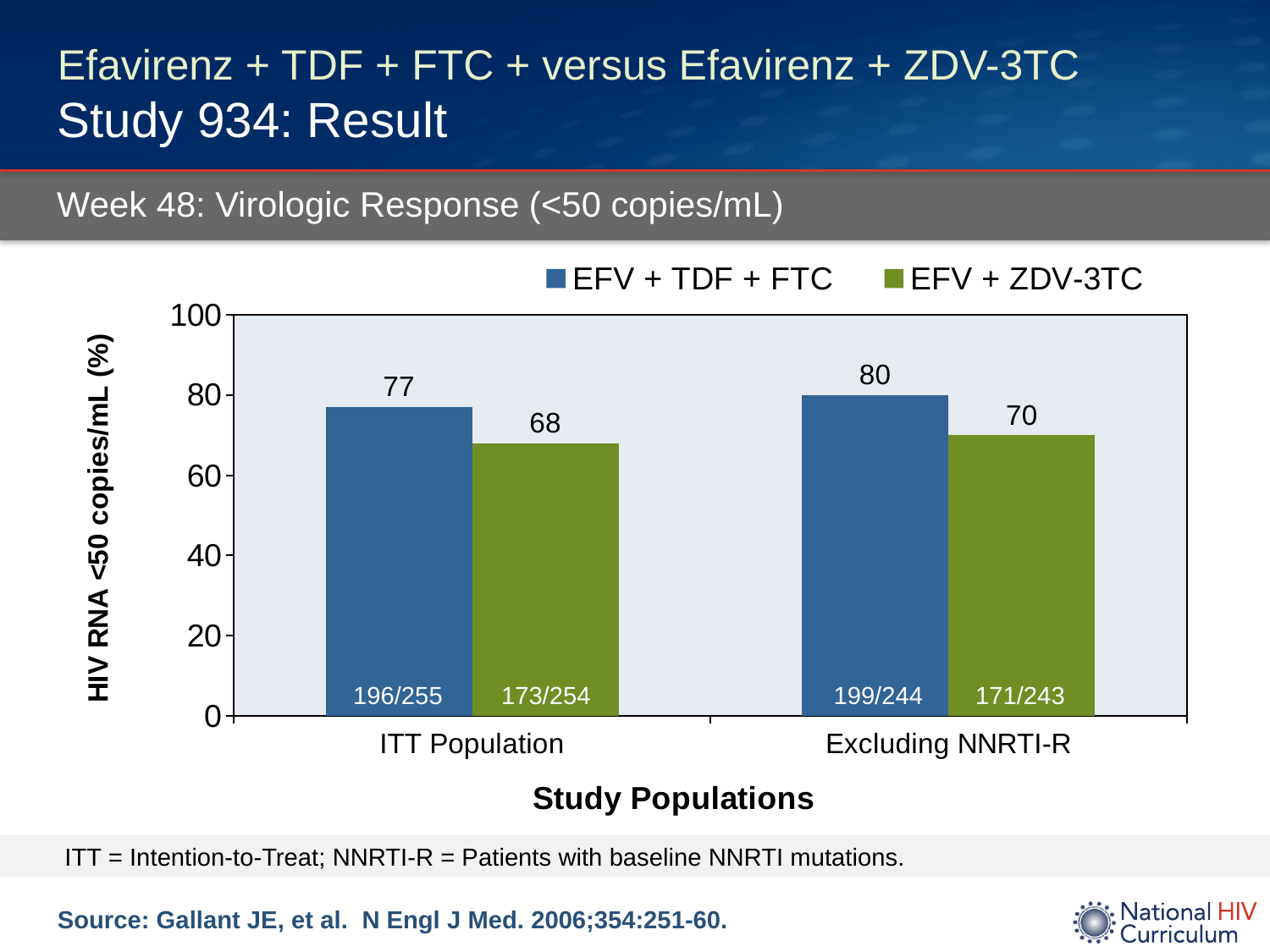
What is the difference between EFV + TDF + FTC and EFV + ZDV-3TC in the ITT Population? 9 Which bar has the lowest value on the chart? EFV + ZDV-3TC, ITT Population What is the value for EFV + TDF + FTC in the Excluding NNRTI-R population? 80 How many series does the legend list? 2 What is the difference between EFV + TDF + FTC and EFV + ZDV-3TC in the Excluding NNRTI-R population? 10 Which is larger in the Excluding NNRTI-R population: EFV + TDF + FTC or EFV + ZDV-3TC? EFV + TDF + FTC What fraction is printed inside the EFV + TDF + FTC bar for the ITT Population? 196/255 What is the value for EFV + ZDV-3TC in the ITT Population? 68 What is the value for EFV + ZDV-3TC in the Excluding NNRTI-R population? 70 What kind of chart is shown on the slide? Bar chart What is the value for EFV + TDF + FTC in the ITT Population? 77 Which bar has the highest value on the chart? EFV + TDF + FTC, Excluding NNRTI-R